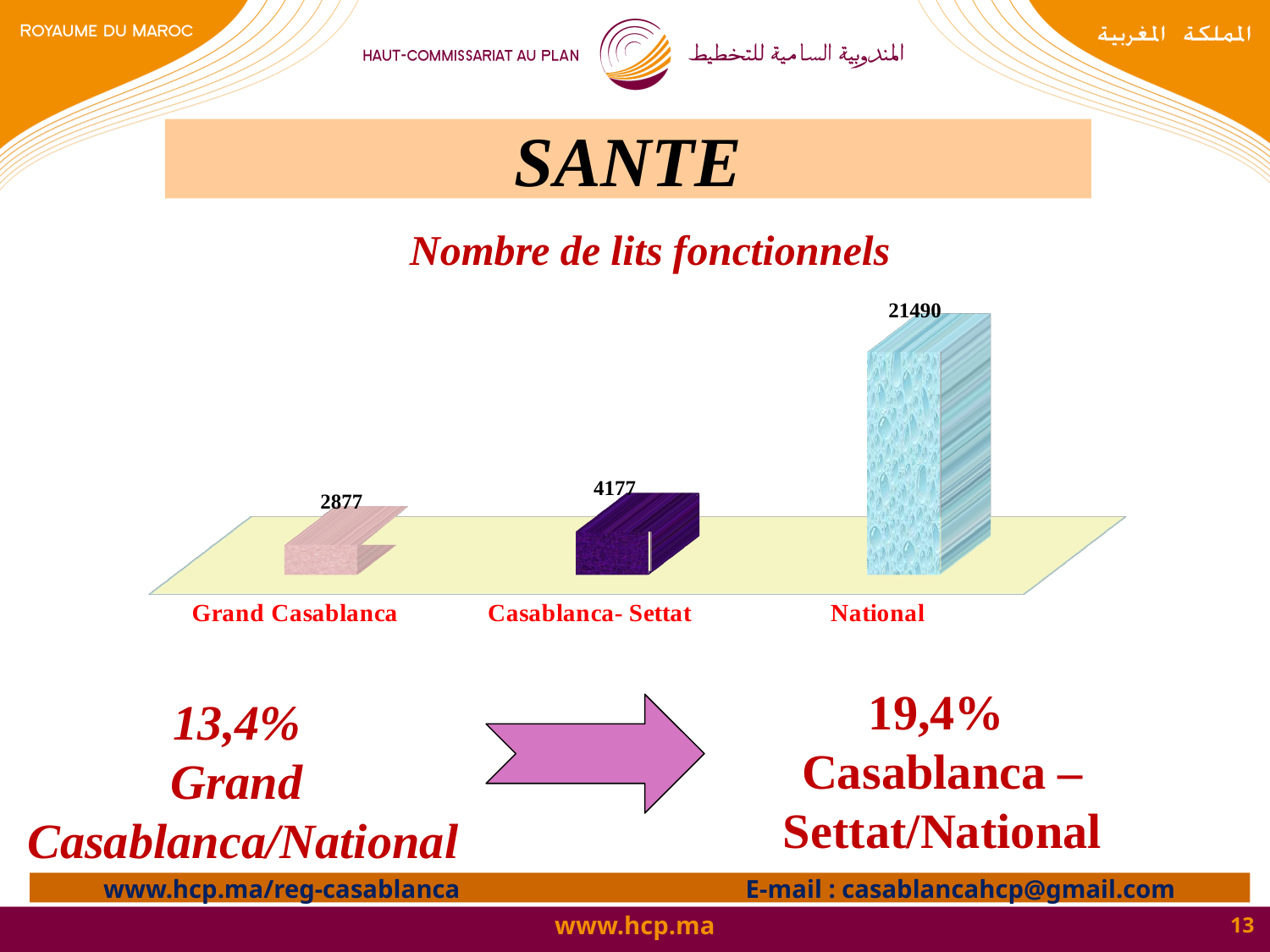
Which has more functional beds, Grand Casablanca or Casablanca- Settat? Casablanca- Settat Which category has the highest number of functional beds? National What is the difference in functional beds between National and Casablanca- Settat? 17313 What is the difference in functional beds between Casablanca- Settat and Grand Casablanca? 1300 What is the number of functional beds (lits fonctionnels) for Grand Casablanca? 2877 What percentage does the slide give for Casablanca – Settat relative to National? 19,4% How many categories are shown in the chart? 3 What is the number of functional beds at the National level? 21490 Which category has the lowest number of functional beds? Grand Casablanca What is the number of functional beds for Casablanca- Settat? 4177 What kind of chart is used to show the number of functional beds? Bar chart What is the title of the chart? Nombre de lits fonctionnels